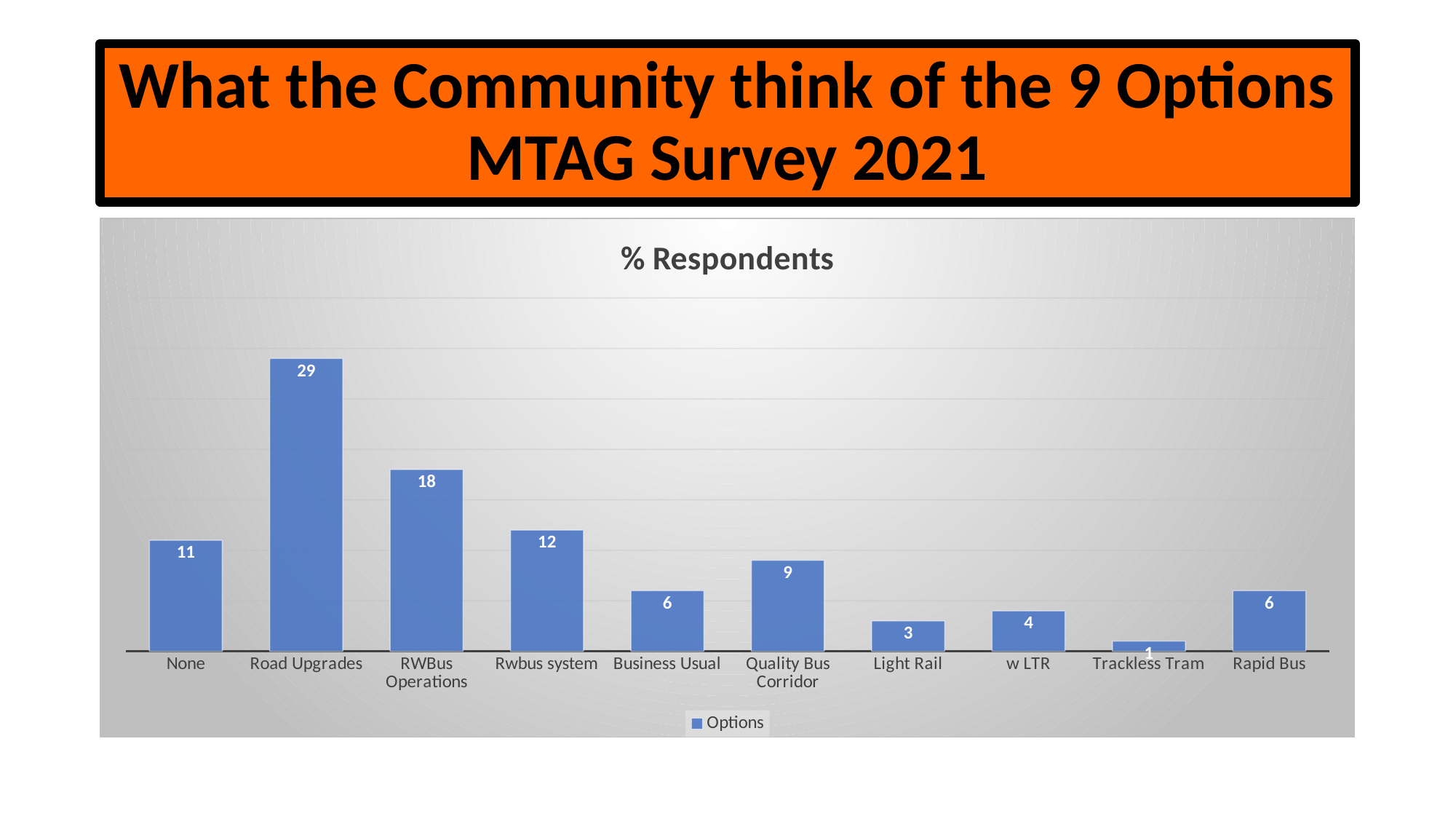
What is the value for RWBus Operations? 18 What is the value for Road Upgrades? 29 Which category has the highest value? Road Upgrades Which category has the lowest value? Trackless Tram What kind of chart is shown? Bar chart How many categories are shown on the x axis? 10 What is the value for Quality Bus Corridor? 9 What is the value for Light Rail? 3 What is the title of the chart? % Respondents Which is larger, the value for None or the value for Rwbus system? Rwbus system How many series does the legend list? 1 What is the difference between the values for Road Upgrades and RWBus Operations? 11